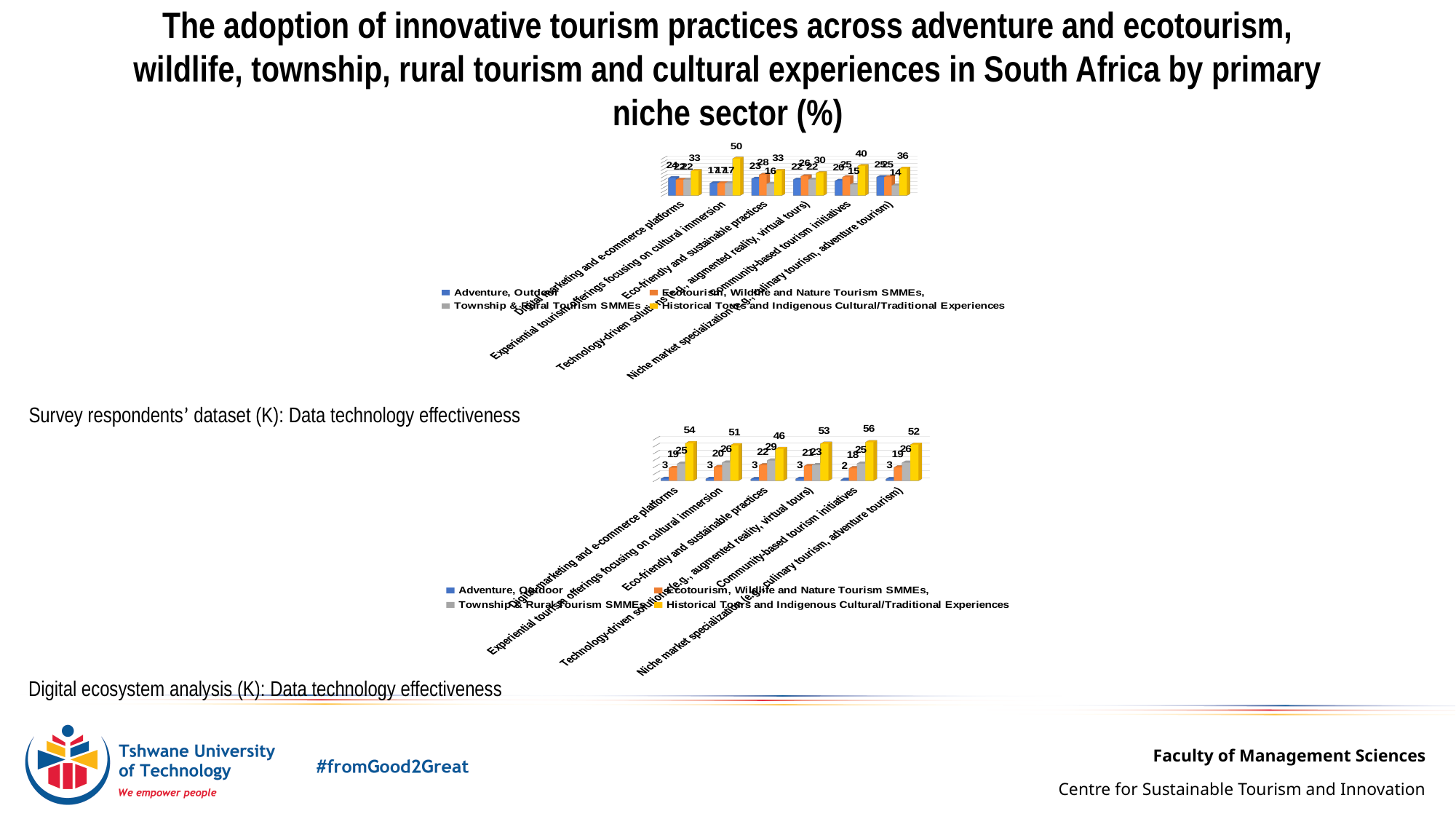
In the top chart (Survey respondents' dataset), which category has the highest value for Historical Tours and Indigenous Cultural/Traditional Experiences? Experiential tourism offerings focusing on cultural immersion How many series does the legend of the bottom chart (Digital ecosystem analysis) list? 4 In the bottom chart (Digital ecosystem analysis), what is the difference between the Historical Tours and Indigenous Cultural/Traditional Experiences values for Community-based tourism initiatives and Eco-friendly and sustainable practices? 10 In the top chart (Survey respondents' dataset), which is larger for Historical Tours and Indigenous Cultural/Traditional Experiences: Community-based tourism initiatives or Niche market specializations? Community-based tourism initiatives In the top chart (Survey respondents' dataset), what is the value for Historical Tours and Indigenous Cultural/Traditional Experiences for Experiential tourism offerings focusing on cultural immersion? 50 In the bottom chart (Digital ecosystem analysis), which category has the lowest value for Historical Tours and Indigenous Cultural/Traditional Experiences? Eco-friendly and sustainable practices In the bottom chart (Digital ecosystem analysis), what is the value for Historical Tours and Indigenous Cultural/Traditional Experiences for Community-based tourism initiatives? 56 How many categories are shown along the x axis of the top chart (Survey respondents' dataset)? 6 What kind of chart is the top chart (Survey respondents' dataset)? Bar chart In the bottom chart (Digital ecosystem analysis), what is the value for Adventure, Outdoor for Community-based tourism initiatives? 2 In the top chart (Survey respondents' dataset), what is the value for Historical Tours and Indigenous Cultural/Traditional Experiences for Community-based tourism initiatives? 40 In the bottom chart (Digital ecosystem analysis), which series is shown in yellow? Historical Tours and Indigenous Cultural/Traditional Experiences